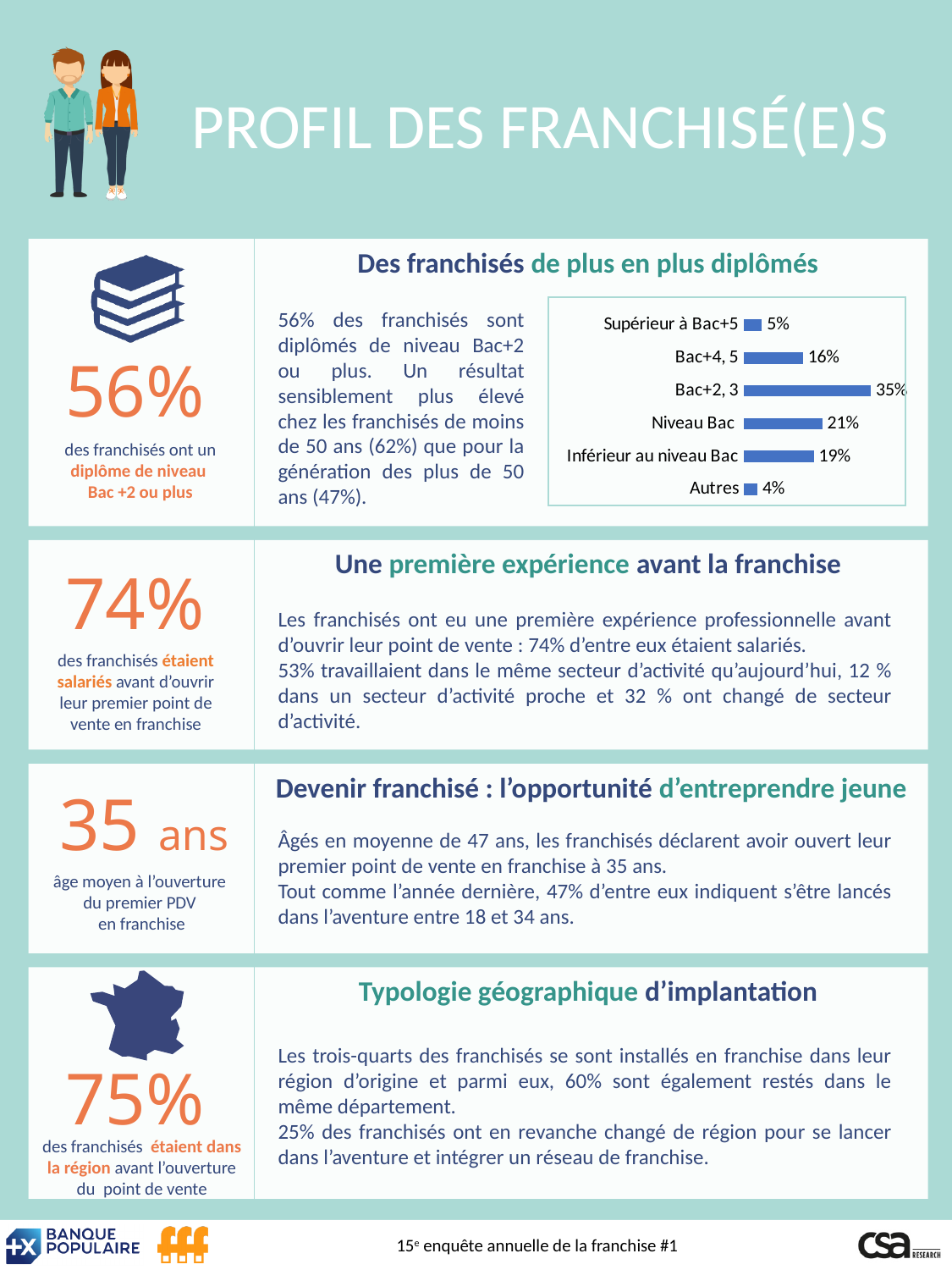
What is the value for "Supérieur à Bac+5" in the bar chart? 5% What is the difference between the values for "Bac+2, 3" and "Niveau Bac" in the bar chart? 14% What is the value for "Niveau Bac" in the bar chart? 21% What colour are the bars in the chart? Blue What is the value for "Bac+2, 3" in the bar chart? 35% What type of chart is shown on the slide? Bar chart Which category has the lowest value in the bar chart? Autres Which is larger in the bar chart: the value for "Niveau Bac" or the value for "Bac+4, 5"? Niveau Bac How many categories are shown in the bar chart? 6 Which category has the highest value in the bar chart? Bac+2, 3 What is the value for "Inférieur au niveau Bac" in the bar chart? 19% What is the difference between the values for "Bac+4, 5" and "Supérieur à Bac+5" in the bar chart? 11%